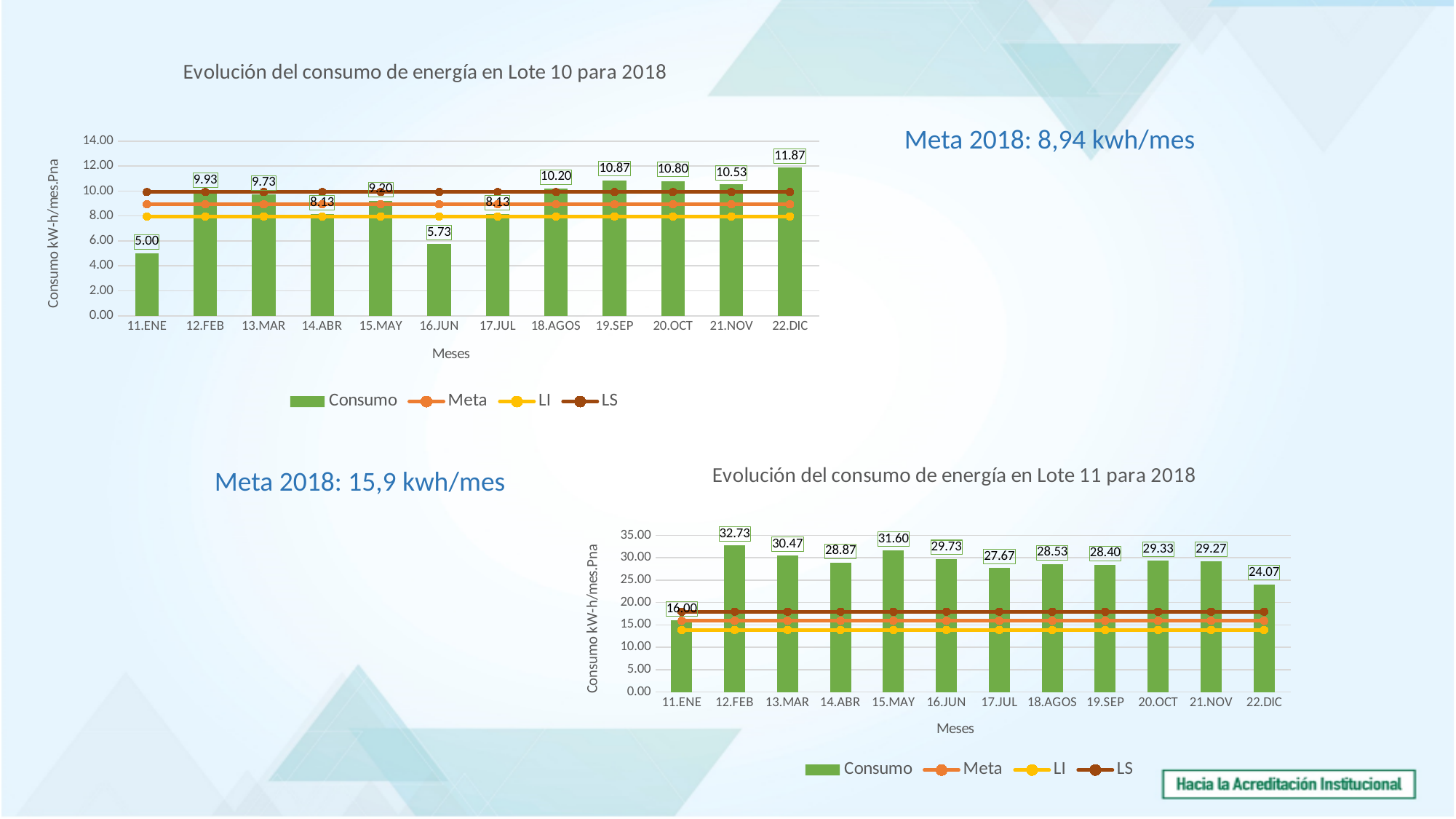
In the chart 'Evolución del consumo de energía en Lote 10 para 2018', how many series does the legend list? 4 In the chart 'Evolución del consumo de energía en Lote 11 para 2018', which month has the highest Consumo value? 12.FEB In the chart 'Evolución del consumo de energía en Lote 11 para 2018', what is the Consumo value for 15.MAY? 31.60 In the chart 'Evolución del consumo de energía en Lote 11 para 2018', is the Consumo value for 17.JUL or 20.OCT larger? 20.OCT In the chart 'Evolución del consumo de energía en Lote 11 para 2018', how many months are shown on the x axis? 12 In the chart 'Evolución del consumo de energía en Lote 10 para 2018', what is the Consumo value for 16.JUN? 5.73 In the chart 'Evolución del consumo de energía en Lote 11 para 2018', which month has the lowest Consumo value? 11.ENE In the chart 'Evolución del consumo de energía en Lote 10 para 2018', which month has the lowest Consumo value? 11.ENE In the chart 'Evolución del consumo de energía en Lote 10 para 2018', what is the difference between the Consumo values for 22.DIC and 11.ENE? 6.87 In the chart 'Evolución del consumo de energía en Lote 10 para 2018', which month has the highest Consumo value? 22.DIC In the chart 'Evolución del consumo de energía en Lote 11 para 2018', what is the difference between the Consumo values for 12.FEB and 22.DIC? 8.66 In the chart 'Evolución del consumo de energía en Lote 10 para 2018', what kind of chart is used for the Consumo series? Bar chart